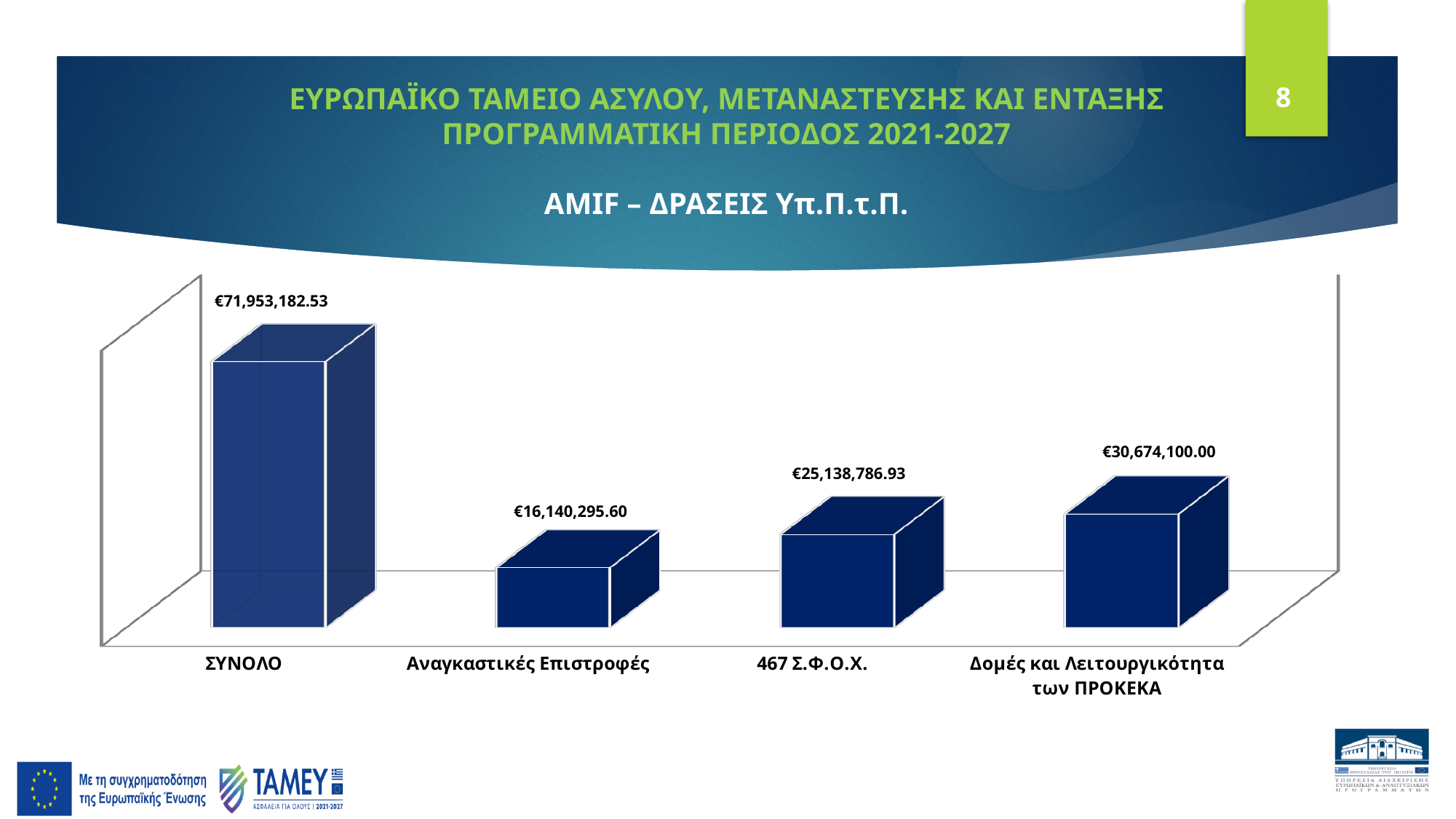
Which category has the lowest value? Αναγκαστικές Επιστροφές What is the value shown for Αναγκαστικές Επιστροφές? €16,140,295.60 What is the value shown for 467 Σ.Φ.Ο.Χ.? €25,138,786.93 What is the value shown for ΣΥΝΟΛΟ? €71,953,182.53 Which is larger, the value for 467 Σ.Φ.Ο.Χ. or the value for Δομές και Λειτουργικότητα των ΠΡΟΚΕΚΑ? Δομές και Λειτουργικότητα των ΠΡΟΚΕΚΑ What is the difference between the values for Δομές και Λειτουργικότητα των ΠΡΟΚΕΚΑ and 467 Σ.Φ.Ο.Χ.? €5,535,313.07 Which category has the highest value? ΣΥΝΟΛΟ What is the difference between the values for 467 Σ.Φ.Ο.Χ. and Αναγκαστικές Επιστροφές? €8,998,491.33 What kind of chart is shown on the slide? Bar chart What is the subtitle of the chart shown on the slide? AMIF – ΔΡΑΣΕΙΣ Υπ.Π.τ.Π. What is the value shown for Δομές και Λειτουργικότητα των ΠΡΟΚΕΚΑ? €30,674,100.00 How many categories are shown on the chart? 4